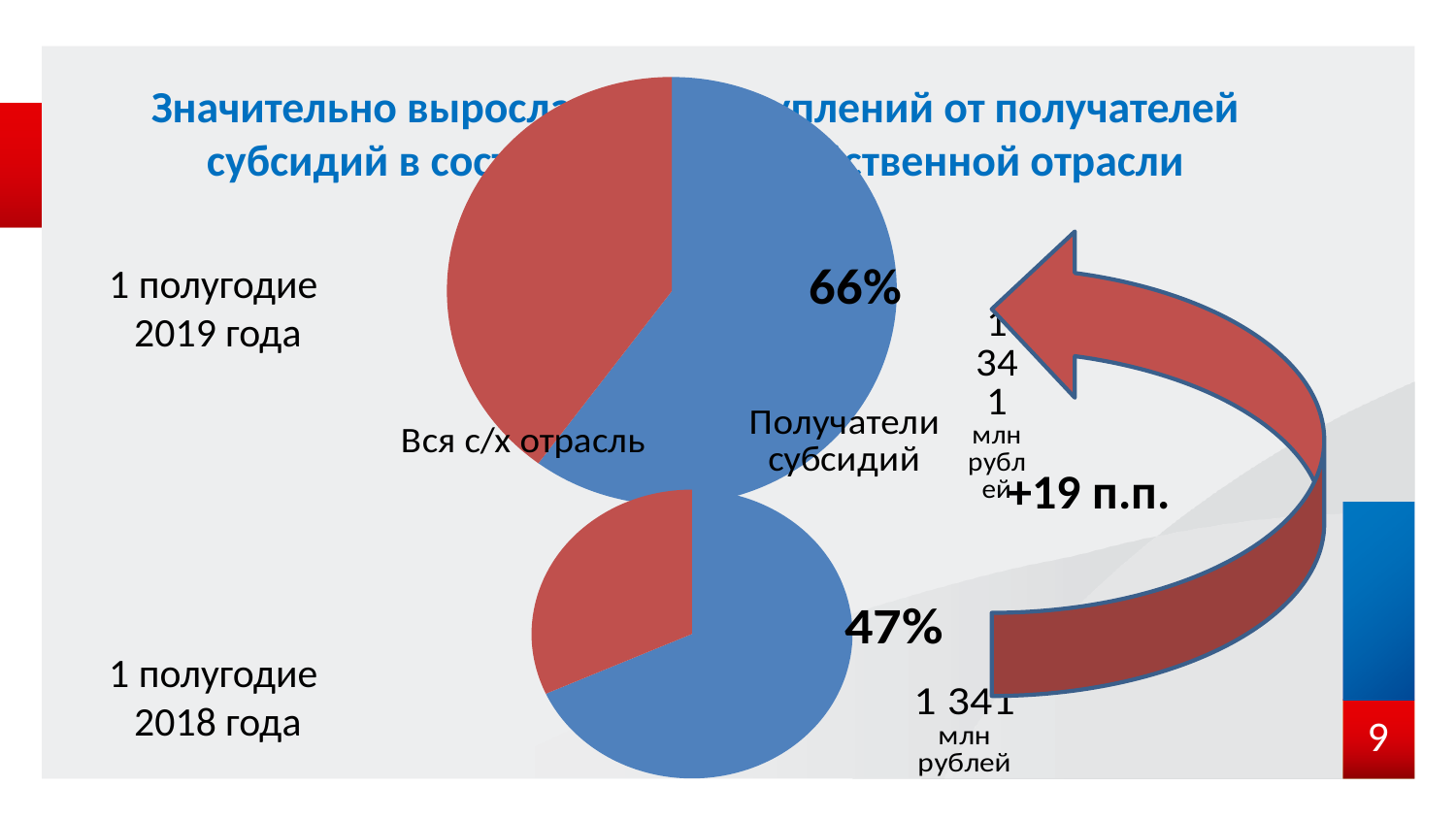
In the top pie chart (1 полугодие 2019 года), which slice is smaller, Вся с/х отрасль or Получатели субсидий? Вся с/х отрасль In the top pie chart (1 полугодие 2019 года), which slice is larger, Вся с/х отрасль or Получатели субсидий? Получатели субсидий What colour is the Вся с/х отрасль slice in the top pie chart? Red What kind of charts are shown on the slide? Pie charts What colour is the Получатели субсидий slice in the top pie chart? Blue How many slices does the top pie chart (1 полугодие 2019 года) have? 2 Which period shows the larger printed share for the blue slice, 1 полугодие 2019 года or 1 полугодие 2018 года? 1 полугодие 2019 года By how many percentage points does the printed share in the 2019 pie chart exceed the printed share in the 2018 pie chart? 19 In the top pie chart (1 полугодие 2019 года), is the share for Получатели субсидий greater or less than 50%? greater How many pie charts are on the slide? 2 In the top pie chart (1 полугодие 2019 года), what share is labelled for Получатели субсидий? 66% In the bottom pie chart (1 полугодие 2018 года), what percentage is printed next to the blue slice? 47%